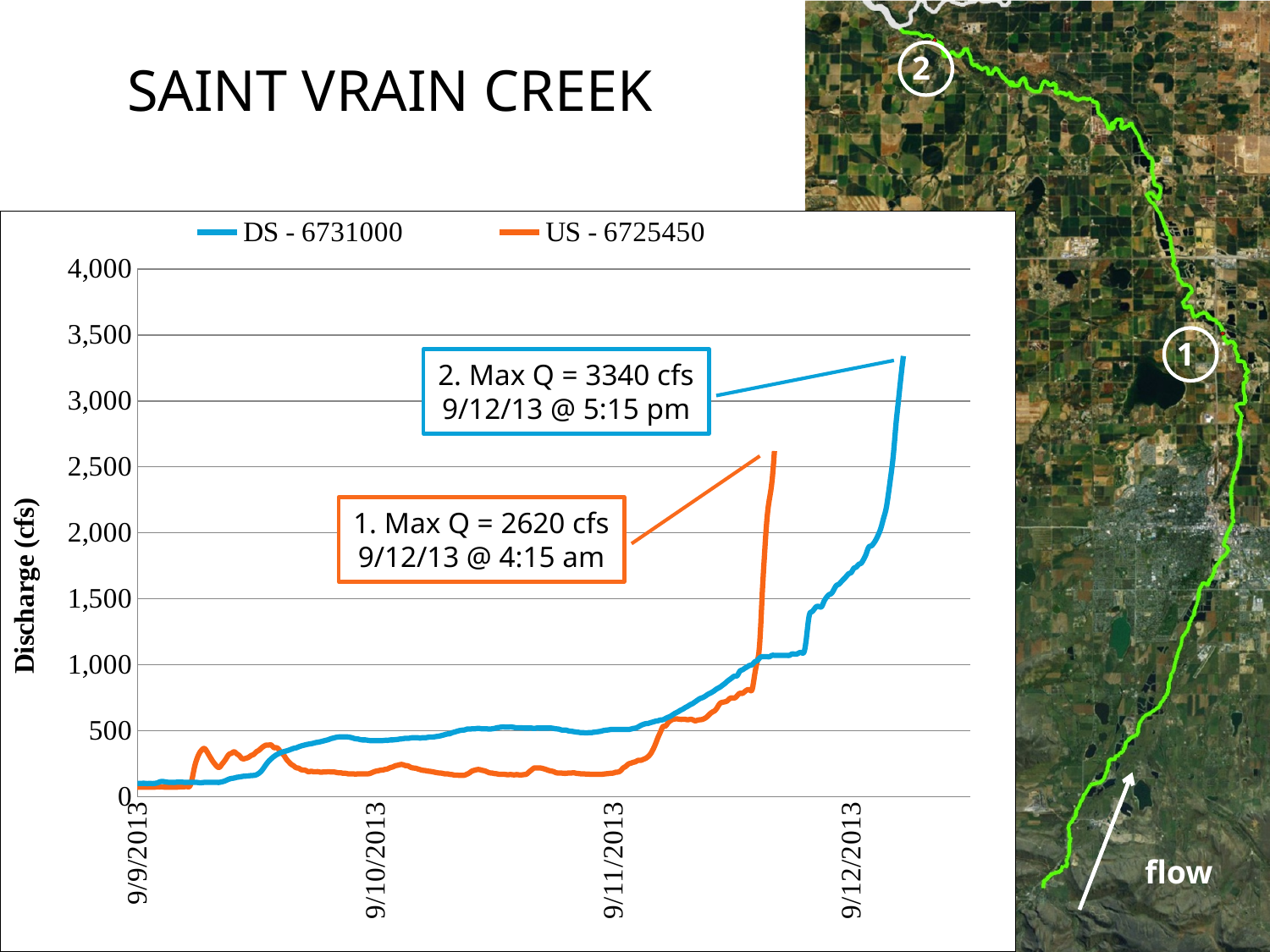
What is the label on the y axis of the chart? Discharge (cfs) What kind of chart is shown on the slide? line chart When did the US - 6725450 series reach its maximum discharge? 9/12/13 @ 4:15 am Which series has the higher peak discharge, DS - 6731000 or US - 6725450? DS - 6731000 What is the maximum discharge (Max Q) for the US - 6725450 series? 2620 cfs Is the peak value of the US - 6725450 series greater or less than 3,000? less Do the discharge values generally rise or fall from 9/9/2013 to 9/12/2013? rise How many series does the legend list? 2 What colour is the line for the US - 6725450 series? orange When did the DS - 6731000 series reach its maximum discharge? 9/12/13 @ 5:15 pm What is the difference between the maximum discharge of DS - 6731000 and that of US - 6725450? 720 cfs What is the maximum discharge (Max Q) for the DS - 6731000 series? 3340 cfs